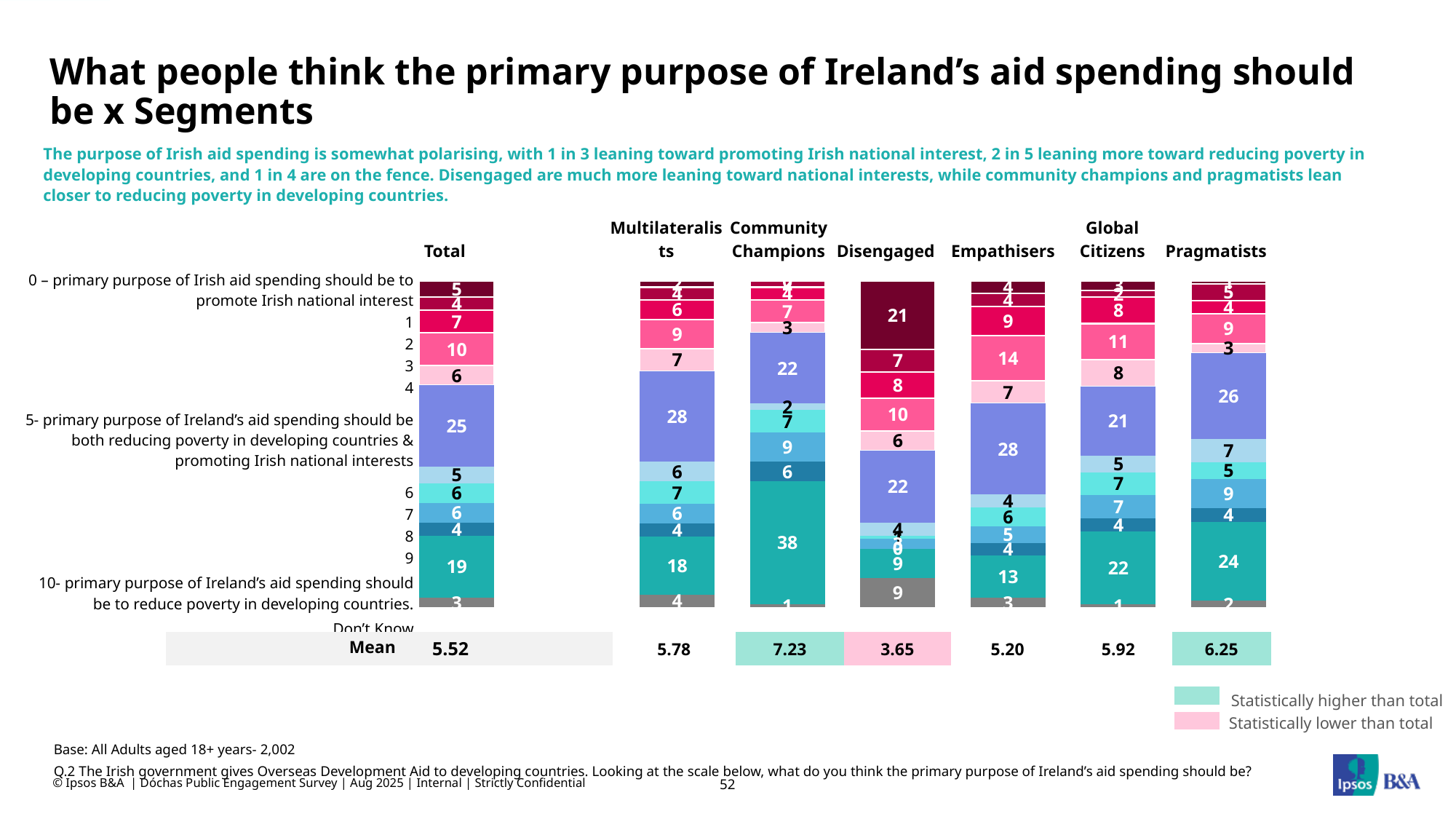
Which segment has the highest Mean value? Community Champions What is the Mean value for the Total bar? 5.52 What is the difference between the Mean for Community Champions and the Mean for Disengaged? 3.58 What percentage of Community Champions chose 10 (primary purpose should be to reduce poverty in developing countries)? 38 What is the Mean value shown for Community Champions? 7.23 What kind of chart is shown on the slide? Stacked bar chart What percentage of the Disengaged segment chose 0 (primary purpose should be to promote Irish national interest)? 21 Which segment has a larger share choosing 10 (reduce poverty in developing countries): Pragmatists or Multilateralists? Pragmatists What percentage of the Total bar chose 5 (both reducing poverty and promoting Irish national interests)? 25 Which segment has the lowest Mean value? Disengaged How many segment bars (including Total) are plotted in the chart? 7 What does the green shading on a Mean value indicate, according to the legend? Statistically higher than total